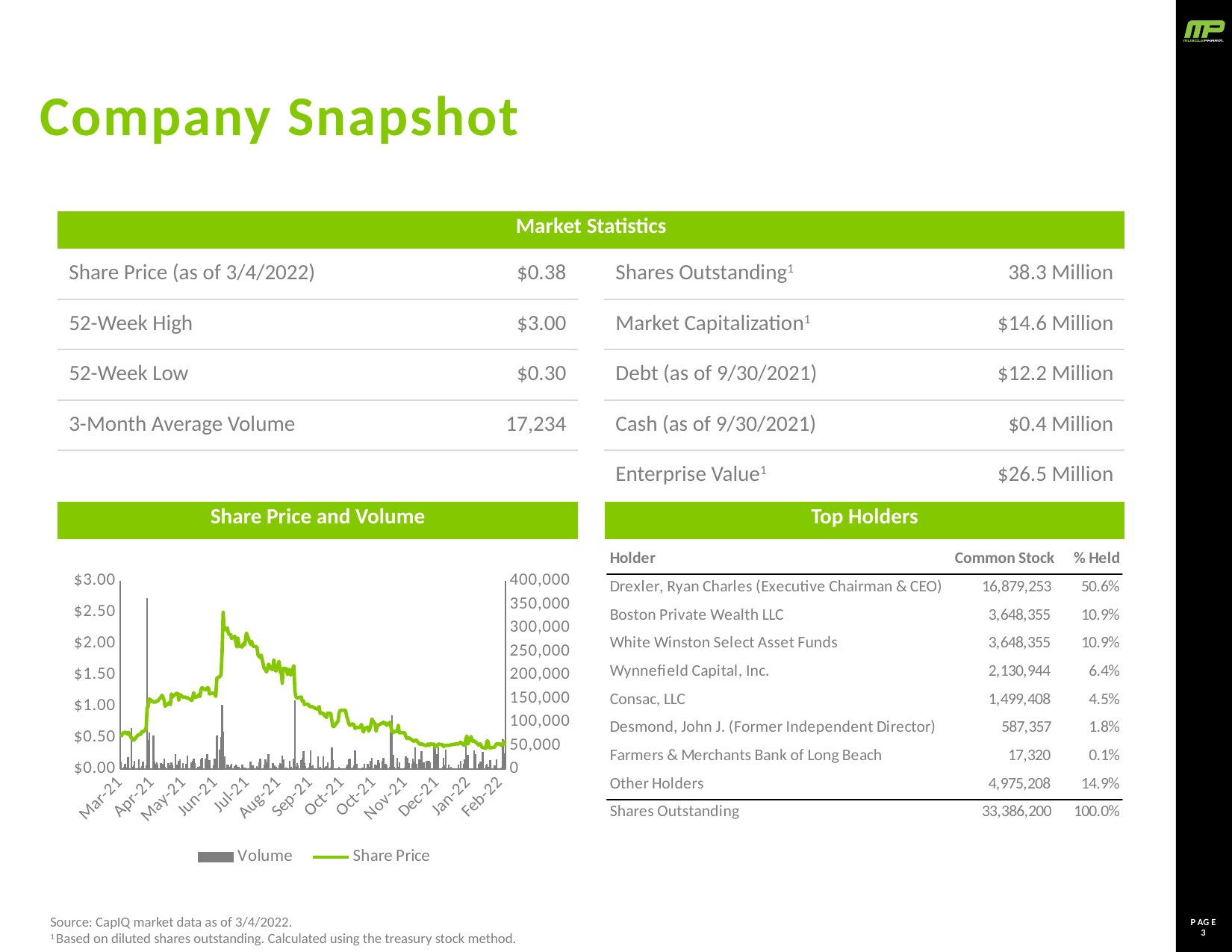
On the "Share Price and Volume" chart, is the share price at Feb-22 greater or less than $1.00? less On the "Share Price and Volume" chart, which series is drawn as a green line? Share Price On the "Share Price and Volume" chart, is the share price at Mar-21 greater or less than $1.00? less What kind of chart is the "Share Price and Volume" chart? A combined bar and line chart On the "Share Price and Volume" chart, what is the highest tick on the right (volume) axis? 400,000 How many series does the legend of the "Share Price and Volume" chart list? 2 On the "Share Price and Volume" chart, is the tallest volume bar greater or less than 300,000? greater What are the two legend entries on the "Share Price and Volume" chart? Volume and Share Price On the "Share Price and Volume" chart, what is the highest tick on the left (share price) axis? $3.00 How many month labels are shown on the x axis of the "Share Price and Volume" chart? 13 On the "Share Price and Volume" chart, does the share price rise or fall from Jul-21 to Feb-22? fall